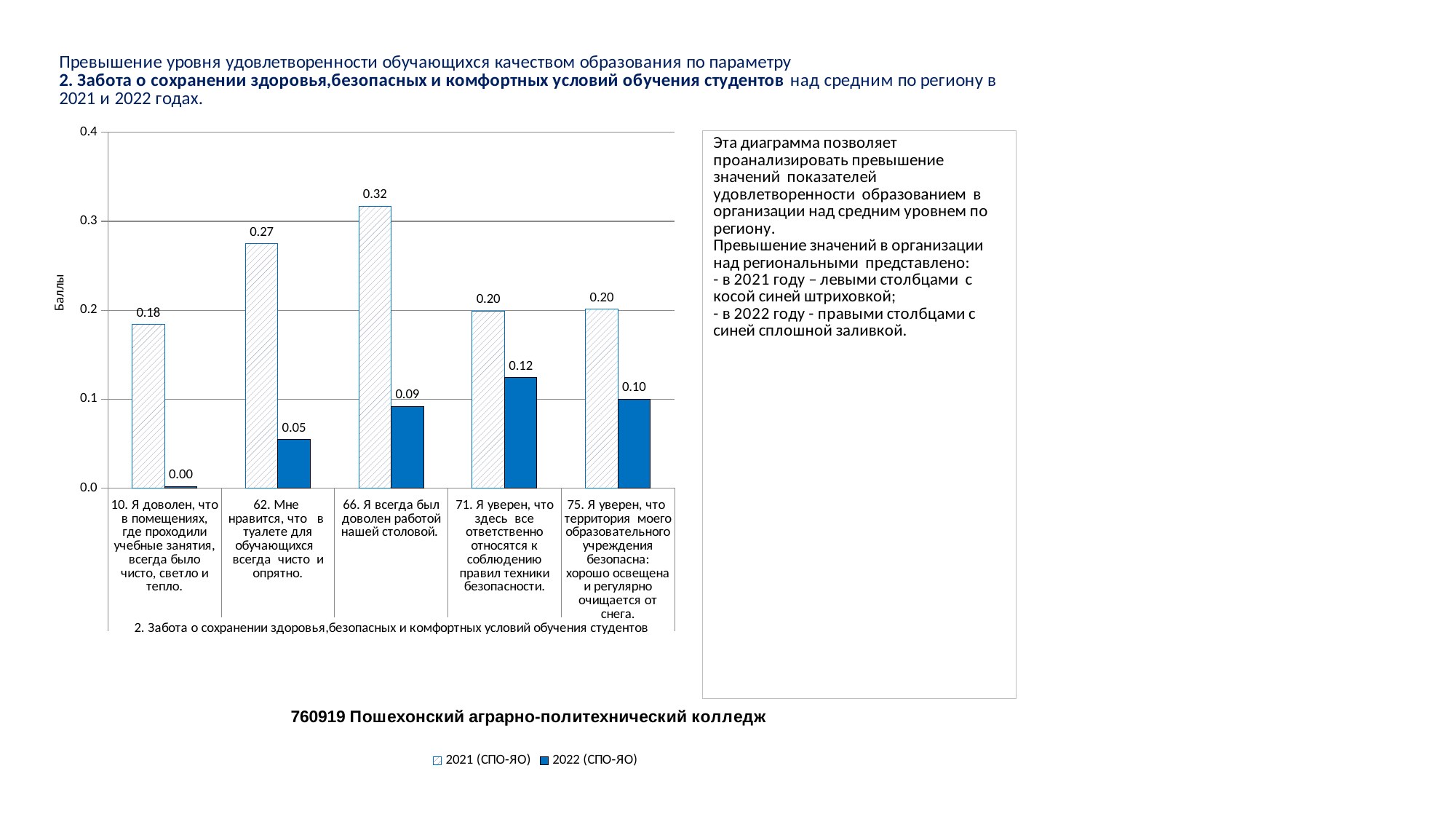
What is the difference between the 2021 and 2022 values for item 66 (Я всегда был доволен работой нашей столовой)? 0.23 How many items (categories) are shown on the x axis of the chart? 5 What is the title of the vertical axis of the chart? Баллы What is the 2022 (СПО-ЯО) value for item 62 (Мне нравится, что в туалете для обучающихся всегда чисто и опрятно)? 0.05 Is the 2021 (СПО-ЯО) value for item 66 greater or less than 0.3? greater How many series does the chart legend list? 2 Which item has the lowest 2022 (СПО-ЯО) value? 10. Я доволен, что в помещениях, где проходили учебные занятия, всегда было чисто, светло и тепло. What is the 2021 (СПО-ЯО) value for item 66 (Я всегда был доволен работой нашей столовой)? 0.32 Which item has the highest 2022 (СПО-ЯО) value? 71. Я уверен, что здесь все ответственно относятся к соблюдению правил техники безопасности. Which item has the highest 2021 (СПО-ЯО) value? 66. Я всегда был доволен работой нашей столовой. What is the 2022 (СПО-ЯО) value for item 10 (Я доволен, что в помещениях, где проходили учебные занятия, всегда было чисто, светло и тепло)? 0.00 For item 71, which is larger: the 2021 (СПО-ЯО) value or the 2022 (СПО-ЯО) value? 2021 (СПО-ЯО)